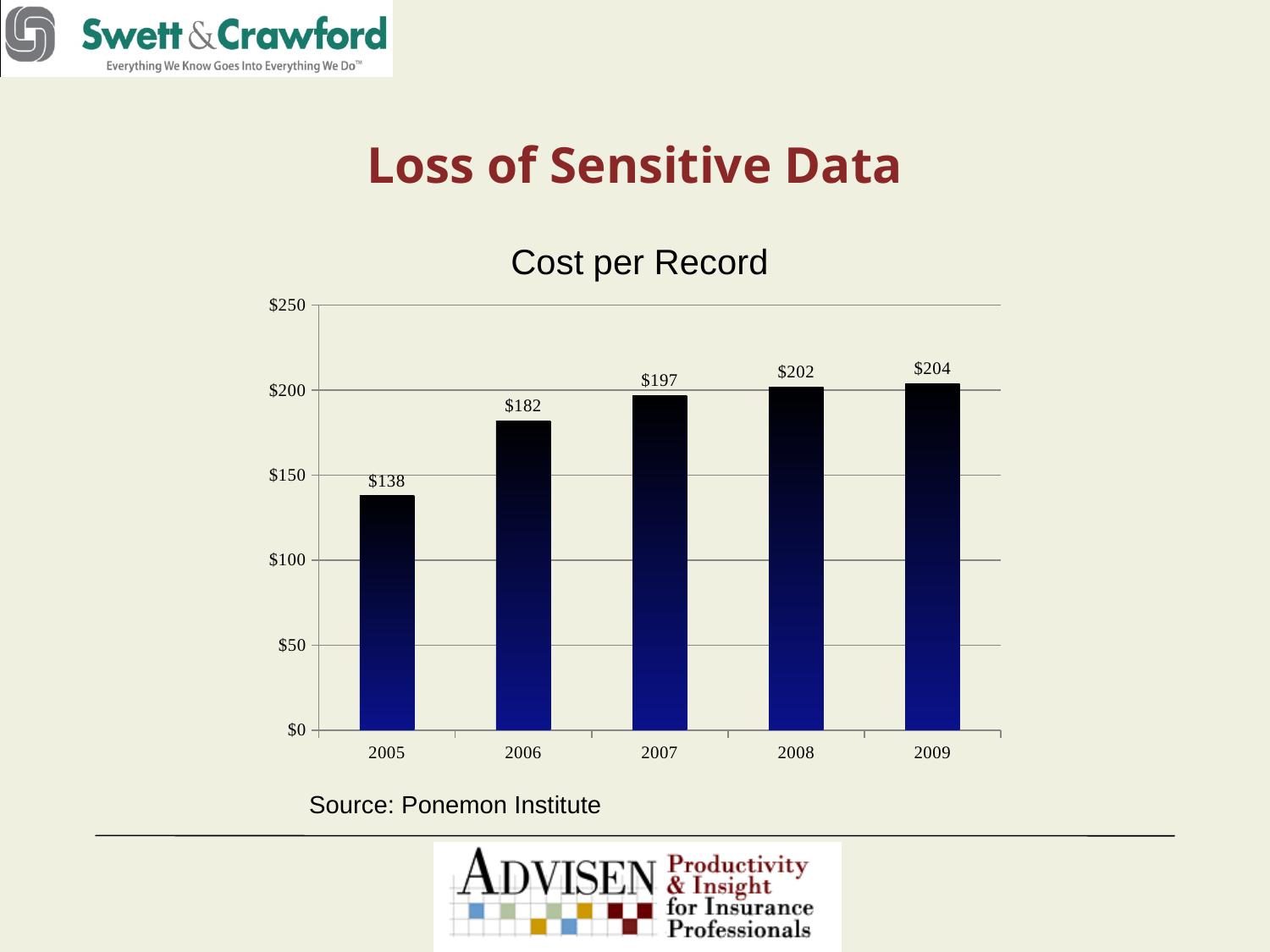
Which year has the lowest cost per record? 2005 Which year has a higher cost per record, 2006 or 2007? 2007 Is the cost per record in 2008 greater or less than $200? greater What is the cost per record in 2007? $197 What kind of chart is shown on the slide? Bar chart How many years are shown on the chart? 5 What is the cost per record in 2005? $138 Which year has the highest cost per record? 2009 What is the difference in cost per record between 2006 and 2005? $44 What is the difference in cost per record between 2009 and 2008? $2 Does the cost per record rise or fall from 2005 to 2009? Rise What is the cost per record in 2009? $204